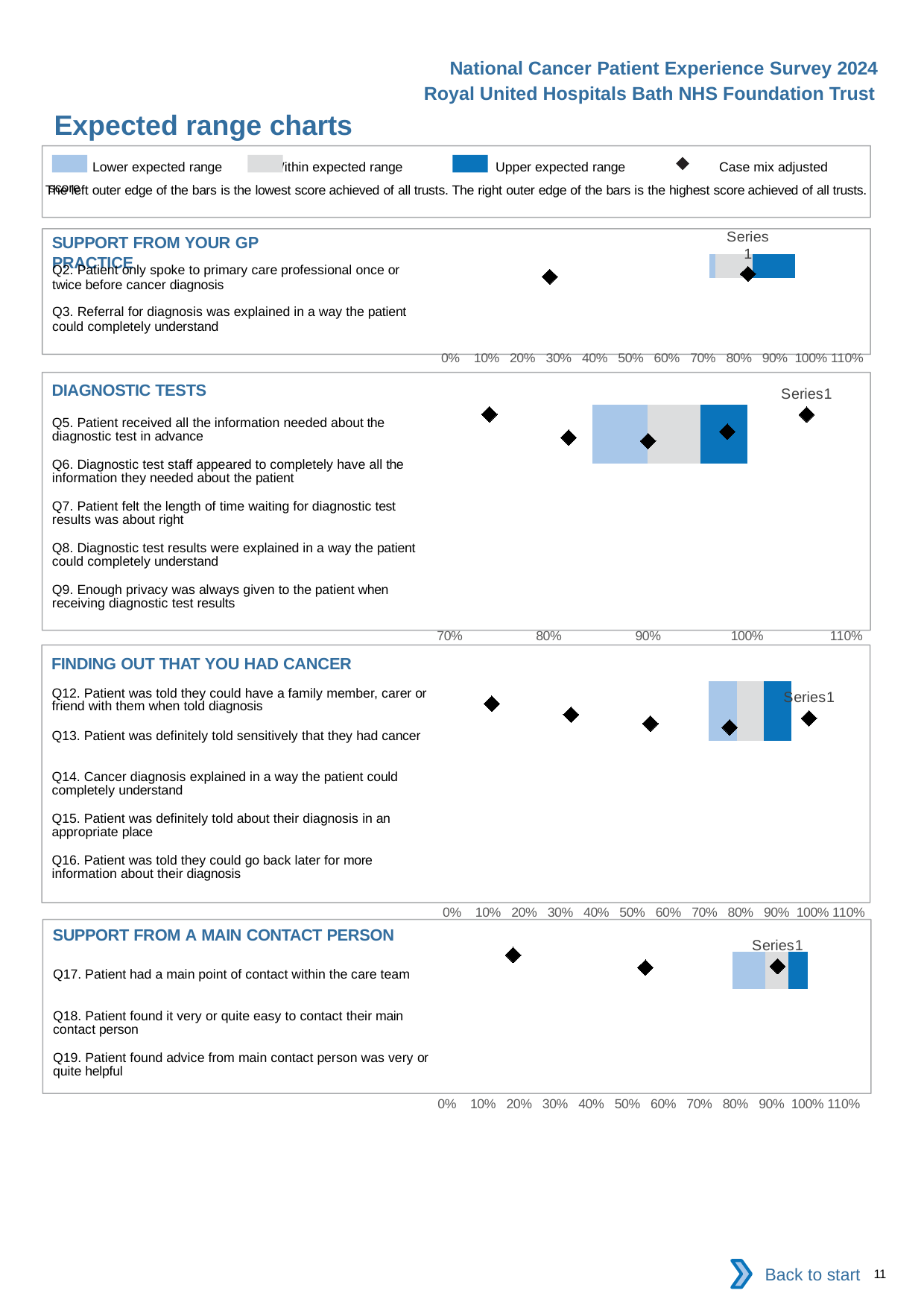
In the 'Support from your GP practice' chart, is the leftmost diamond marker greater or less than 40%? less In the 'Support from a main contact person' chart, is the rightmost diamond marker greater or less than 80%? greater What is the title of the slide containing these charts? Expected range charts How many entries does the legend at the top of the slide list? 4 How many questions are listed in the 'Finding out that you had cancer' chart? 5 What kind of chart is used in the 'Diagnostic tests' section? Bar chart How many questions are listed in the 'Support from a main contact person' chart? 3 In the 'Diagnostic tests' chart, what is the lowest value shown on the x axis? 70% In the 'Finding out that you had cancer' chart, is the leftmost diamond marker greater or less than 20%? less How many questions are listed in the 'Support from your GP practice' chart? 2